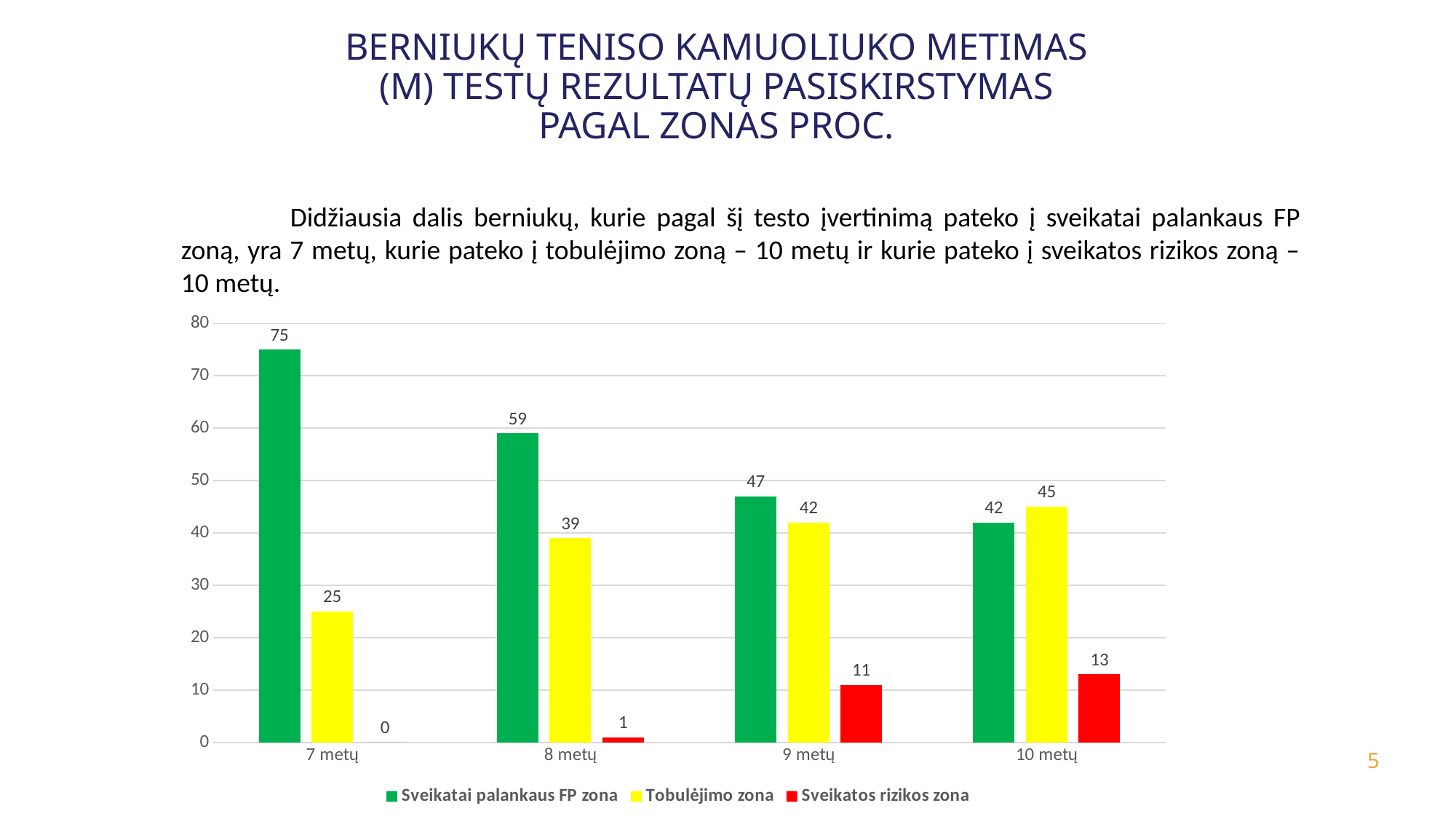
Which age group has the highest value for Sveikatai palankaus FP zona? 7 metų What is the difference between the Sveikatai palankaus FP zona values for 7 metų and 8 metų? 16 What is the value for Sveikatai palankaus FP zona at 7 metų? 75 Which age group has the lowest value for Sveikatos rizikos zona? 7 metų What colour represents Sveikatos rizikos zona in the chart? Red What is the value for Sveikatos rizikos zona at 10 metų? 13 How many series does the legend list? 3 What is the value for Tobulėjimo zona at 9 metų? 42 At 10 metų, which is larger: Sveikatai palankaus FP zona or Tobulėjimo zona? Tobulėjimo zona How many age groups are shown on the x axis? 4 What kind of chart is shown on the slide? Bar chart Do the Sveikatai palankaus FP zona values rise or fall from 7 metų to 10 metų? Fall